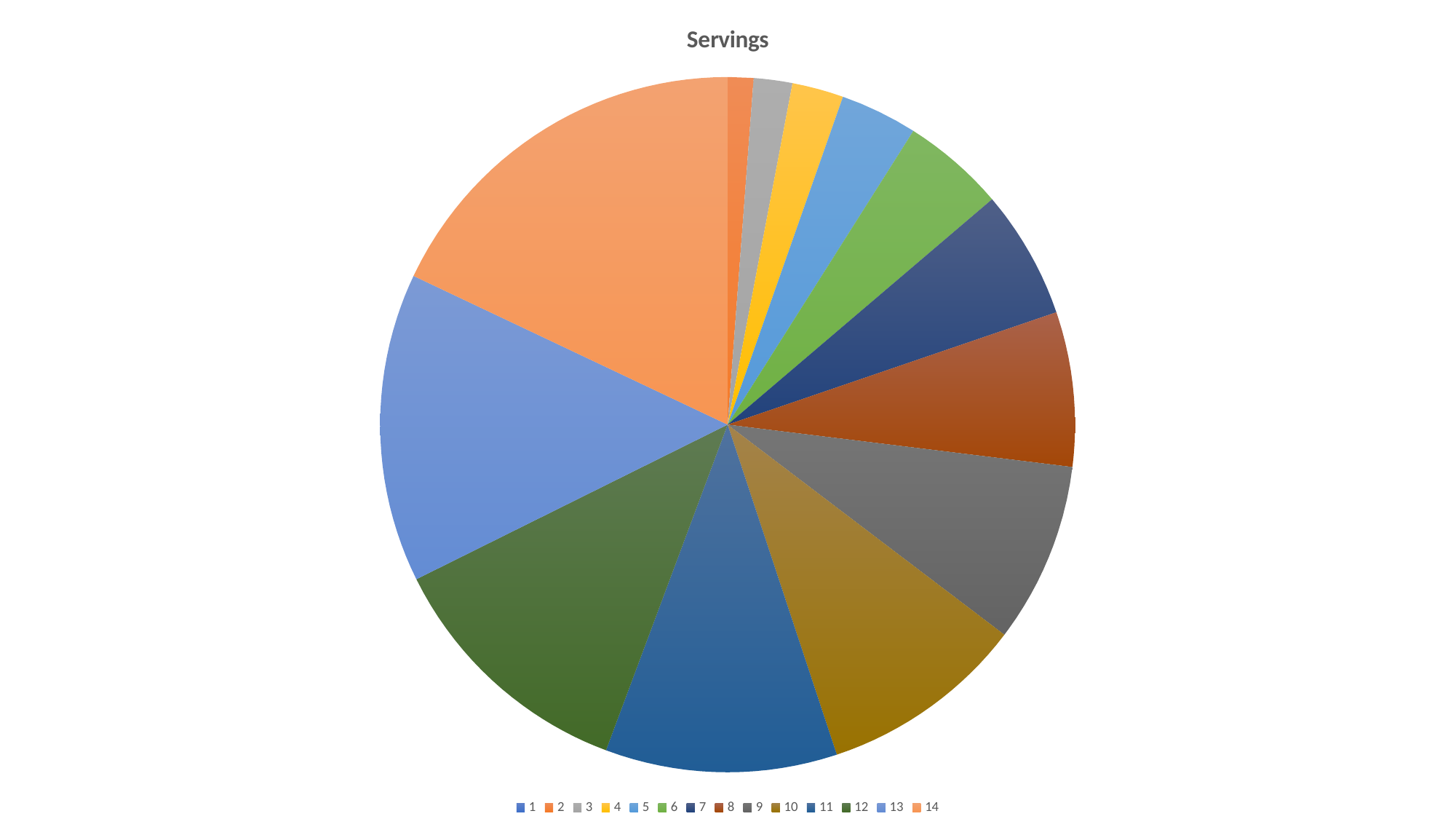
How many categories does the legend list? 14 Going from category 2 to category 14, do the slices generally get larger or smaller? larger Which slice is larger, 9 or 4? 9 Which slice is larger, 8 or 3? 8 Which slice is larger, 14 or 13? 14 Where is the legend placed relative to the pie? below the pie What is the title of the chart? Servings Which category has the largest slice of the pie? 14 What kind of chart is shown on the slide? pie chart